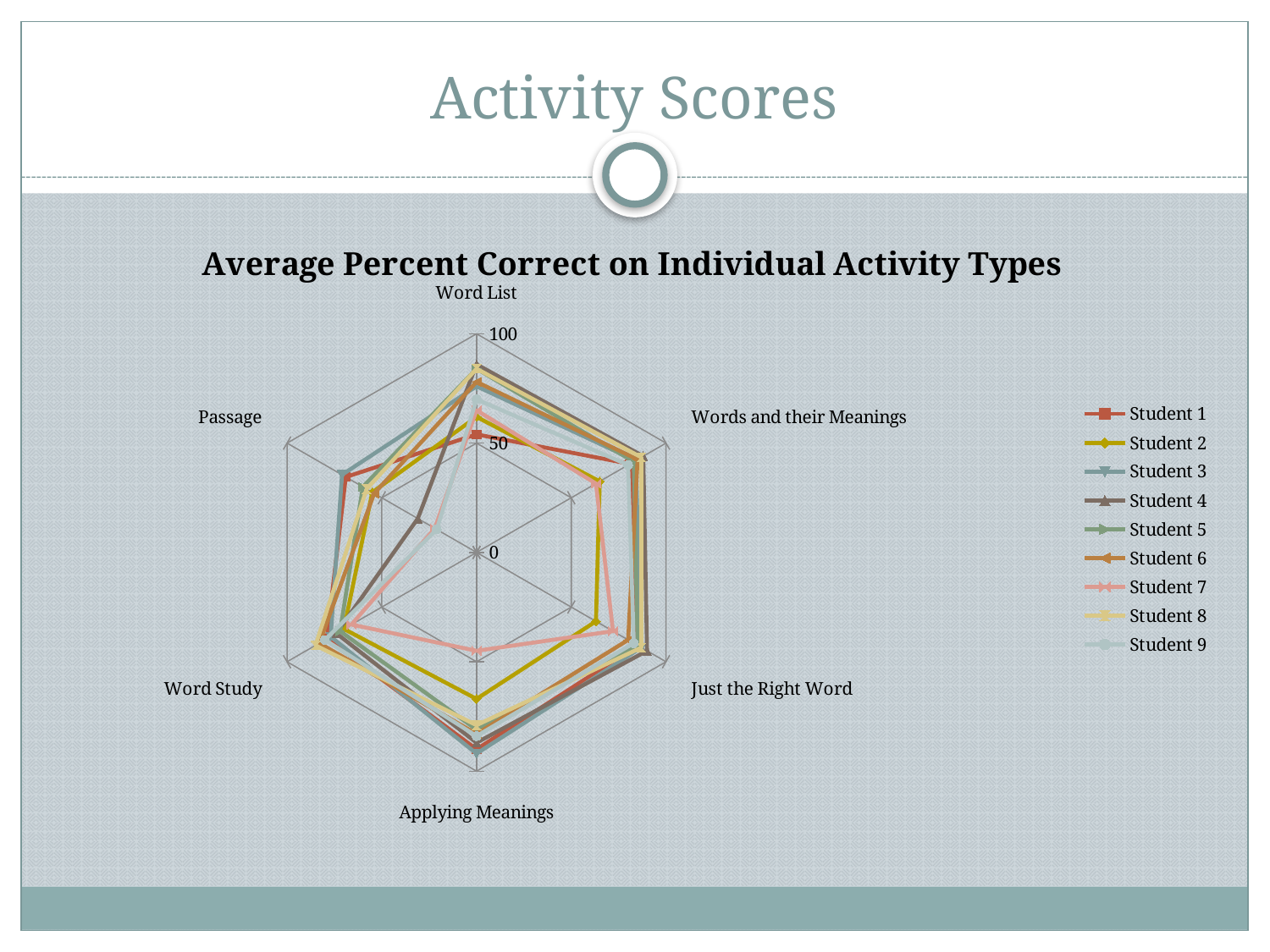
On which activity type does Student 7 have the lowest score? Passage How many activity types (categories) are plotted on the radar chart? 6 How many series does the legend list? 9 Is the value for Student 7 on Passage greater or less than 50? less What is the maximum value shown on the chart's axis scale? 100 Is the value for Student 9 on Passage greater or less than 50? less What kind of chart is shown on the slide? Radar chart On which activity type does Student 1 have the lowest score? Word List Is the value for Student 3 on Word Study greater or less than 50? greater What is the title of the chart? Average Percent Correct on Individual Activity Types For Student 7, which is larger: the score on Passage or the score on Word Study? Word Study